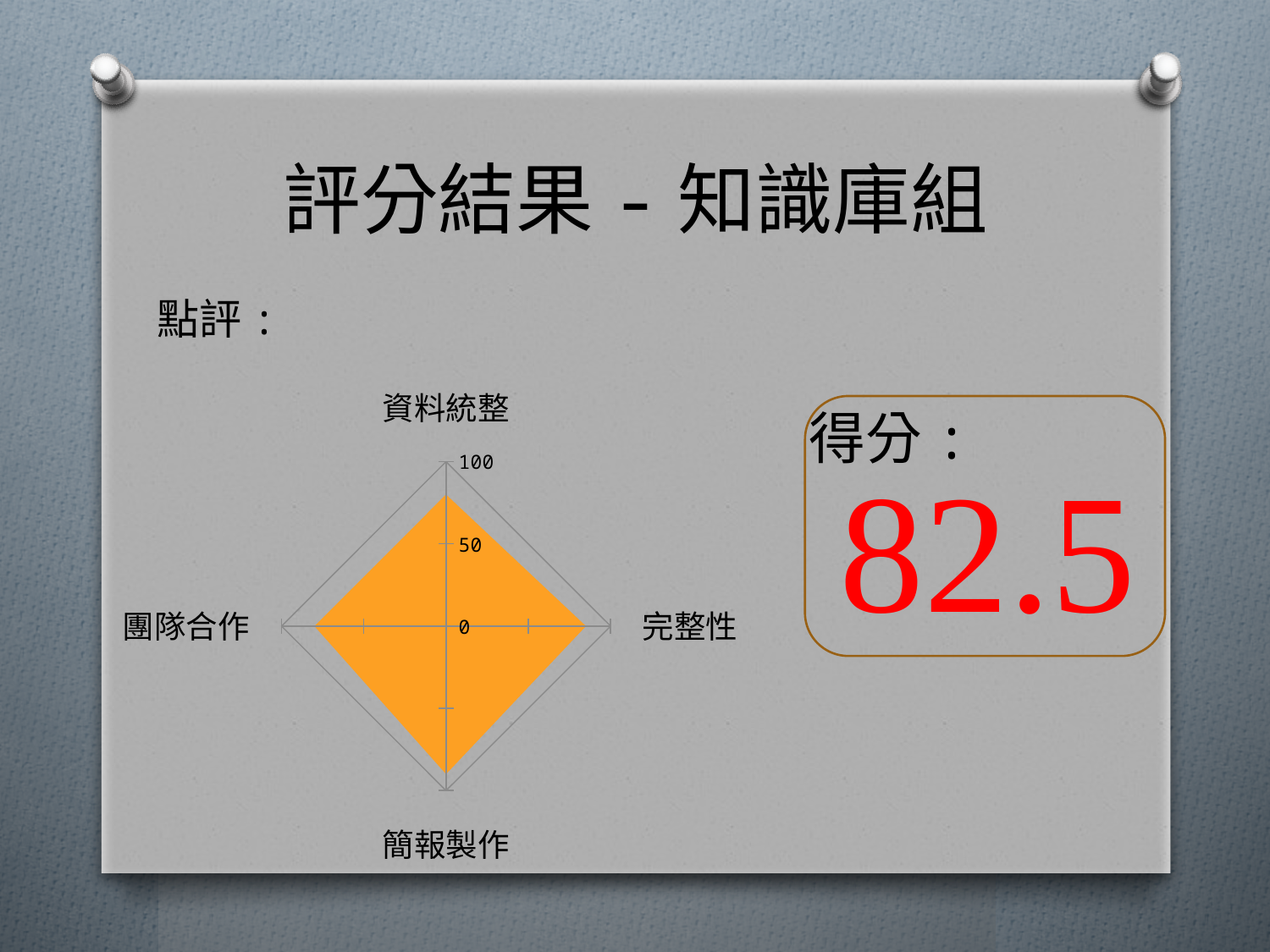
Which category has the highest value on the radar chart? 簡報製作 What colour is the filled area of the radar chart? orange Is the value for 團隊合作 greater or less than 50? greater Is the value for 資料統整 greater or less than 50? greater Which is larger, the value for 簡報製作 or the value for 資料統整? 簡報製作 What kind of chart is shown on the slide? radar chart What is the maximum tick value shown on the radar chart's axis? 100 Which is larger, the value for 簡報製作 or the value for 團隊合作? 簡報製作 Is the value for 簡報製作 greater or less than 50? greater How many categories (axes) does the radar chart have? 4